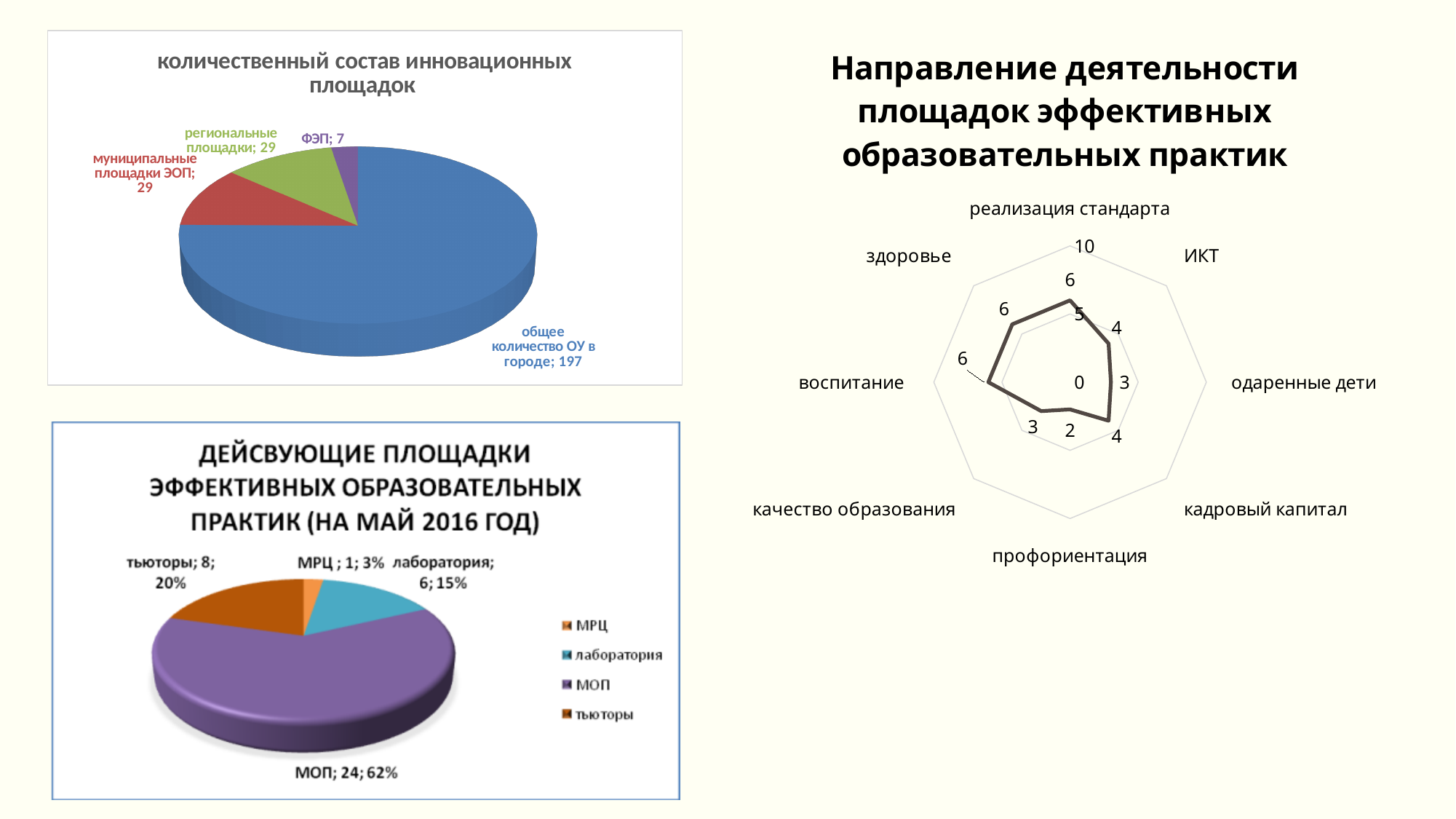
In the bottom-left pie chart 'ДЕЙСВУЮЩИЕ ПЛОЩАДКИ ЭФФЕКТИВНЫХ ОБРАЗОВАТЕЛЬНЫХ ПРАКТИК (НА МАЙ 2016 ГОД)', which category has the largest value? МОП In the pie chart titled 'количественный состав инновационных площадок', how many slices are there? 4 In the pie chart titled 'количественный состав инновационных площадок', what is the value for 'общее количество ОУ в городе'? 197 In the bottom-left pie chart 'ДЕЙСВУЮЩИЕ ПЛОЩАДКИ ЭФФЕКТИВНЫХ ОБРАЗОВАТЕЛЬНЫХ ПРАКТИК (НА МАЙ 2016 ГОД)', what is the count for 'тьюторы'? 8 In the pie chart titled 'количественный состав инновационных площадок', what is the value for 'ФЭП'? 7 In the pie chart titled 'количественный состав инновационных площадок', which category has the smallest value? ФЭП In the bottom-left pie chart 'ДЕЙСВУЮЩИЕ ПЛОЩАДКИ ЭФФЕКТИВНЫХ ОБРАЗОВАТЕЛЬНЫХ ПРАКТИК (НА МАЙ 2016 ГОД)', how many entries does the legend list? 4 In the pie chart titled 'количественный состав инновационных площадок', what is the difference between 'муниципальные площадки ЭОП' and 'ФЭП'? 22 In the radar chart 'Направление деятельности площадок эффективных образовательных практик', which category has the lowest value? профориентация In the bottom-left pie chart 'ДЕЙСВУЮЩИЕ ПЛОЩАДКИ ЭФФЕКТИВНЫХ ОБРАЗОВАТЕЛЬНЫХ ПРАКТИК (НА МАЙ 2016 ГОД)', which is larger, 'лаборатория' or 'тьюторы'? тьюторы What kind of chart is the chart on the right titled 'Направление деятельности площадок эффективных образовательных практик'? radar chart In the bottom-left pie chart 'ДЕЙСВУЮЩИЕ ПЛОЩАДКИ ЭФФЕКТИВНЫХ ОБРАЗОВАТЕЛЬНЫХ ПРАКТИК (НА МАЙ 2016 ГОД)', what share of the pie does 'МОП' have? 62%